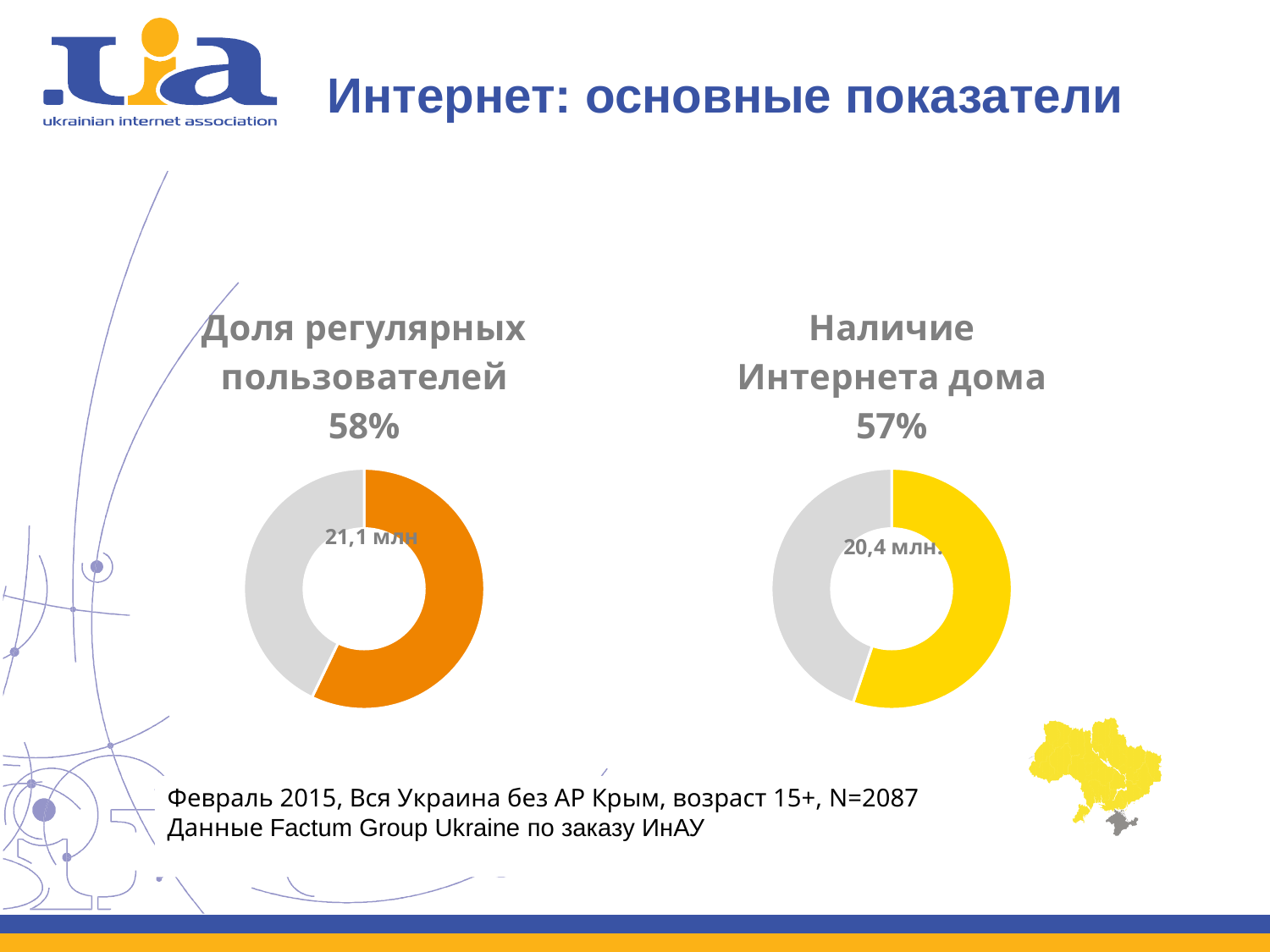
What value is printed inside the right chart "Наличие Интернета дома"? 20,4 млн. What colour is the highlighted slice in the right chart "Наличие Интернета дома"? Yellow Which is larger: the share of regular users (left chart) or the share with Internet at home (right chart)? Share of regular users (58%) How many donut charts are shown on the slide? 2 In the right chart "Наличие Интернета дома", is the highlighted share greater or less than 50%? greater What kind of chart is used for "Доля регулярных пользователей" on the left? Donut (pie) chart What colour is the highlighted slice in the left chart "Доля регулярных пользователей"? Orange What value is printed inside the left chart "Доля регулярных пользователей"? 21,1 млн In the left chart "Доля регулярных пользователей", what share does the orange slice represent? 58% What is the sample size (N) stated on the slide for the data? N=2087 What is the difference in percentage points between the left chart's 58% and the right chart's 57%? 1 percentage point In the right chart "Наличие Интернета дома", what share does the yellow slice represent? 57%